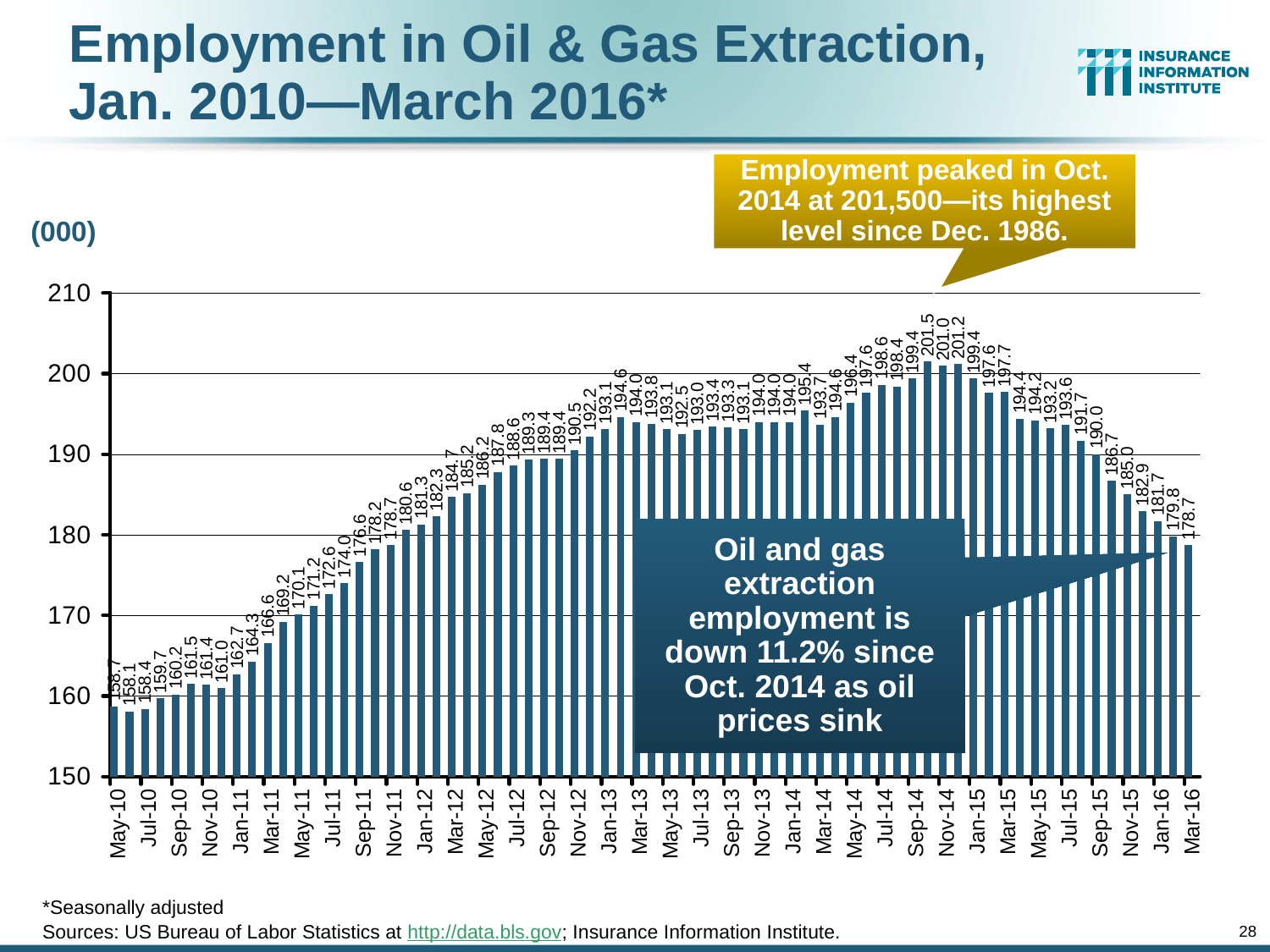
Is the value for Nov-15 greater or less than 180? greater Which is larger, the value for Jan-16 or the value for Mar-16? Jan-16 What is the employment value shown for Mar-16? 178.7 How much higher is the Oct-14 value (201.5) than the May-10 value (158.7)? 42.8 By how much did employment fall from its Oct-14 peak of 201.5 to the Mar-16 value of 178.7? 22.8 Is the value for Jan-11 greater or less than 170? less What is the employment value shown for Jan-16? 181.7 In which month did employment in oil & gas extraction peak, and at what value? Oct. 2014, 201.5 What kind of chart is used to show employment in oil & gas extraction? Bar chart What is the employment value shown for May-10, the first bar on the chart? 158.7 According to the callout on the chart, by what percentage is oil and gas extraction employment down since Oct. 2014? 11.2% Do the values generally rise or fall from May-10 through Oct-14? Rise